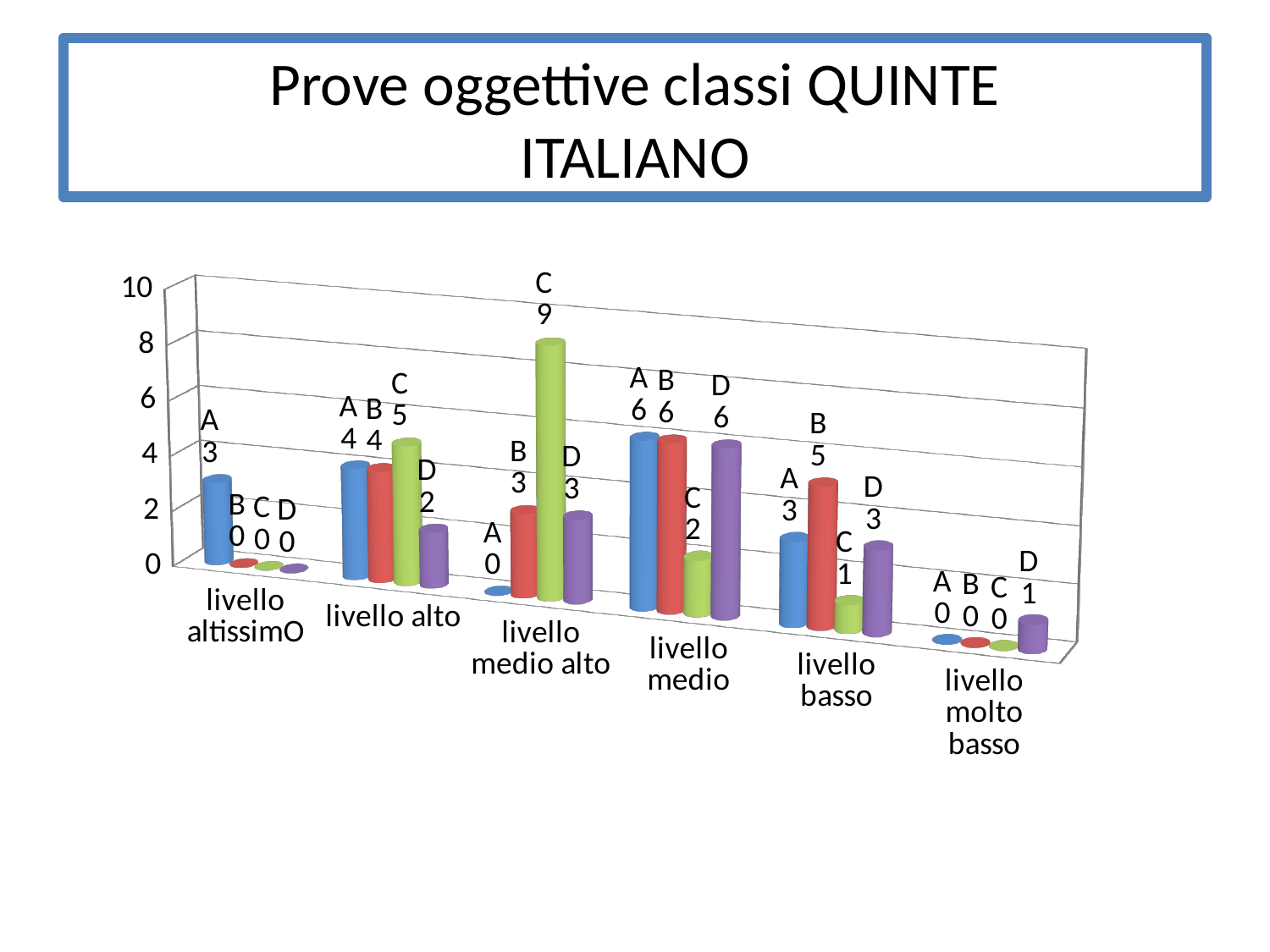
What is the value for series D at livello alto? 2 How many level categories are shown on the x axis? 6 What is the value for series A at livello altissimo? 3 What kind of chart is shown on the slide? bar chart What is the value for series B at livello basso? 5 What is the value for series C at livello medio alto? 9 Which is larger at livello basso: series B or series D? B Which series has the highest value at livello medio alto? C What is the title of the slide containing the chart? Prove oggettive classi QUINTE ITALIANO Which series has the lowest value at livello medio? C How many series (bars) are plotted for each level category? 4 What is the difference between series C and series D at livello alto? 3